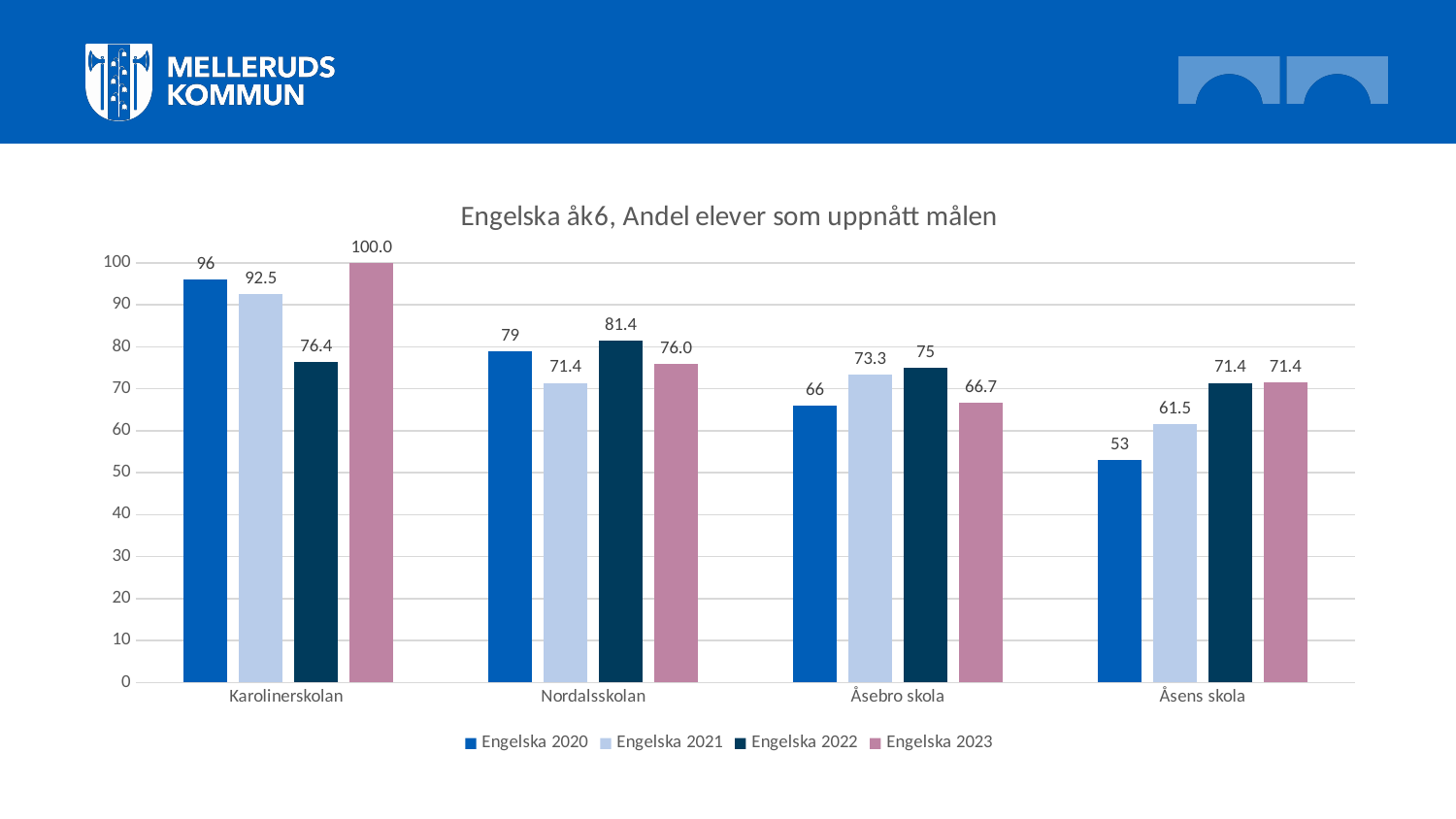
What kind of chart is shown on the slide? Bar chart What is the value for Engelska 2023 at Karolinerskolan? 100.0 Which school has the lowest value for Engelska 2021? Åsens skola Which is larger at Nordalsskolan: Engelska 2020 or Engelska 2021? Engelska 2020 What is the value for Engelska 2021 at Åsebro skola? 73.3 What is the title of the chart? Engelska åk6, Andel elever som uppnått målen What is the value for Engelska 2020 at Åsens skola? 53 What is the difference between Engelska 2020 and Engelska 2021 at Karolinerskolan? 3.5 What is the value for Engelska 2022 at Nordalsskolan? 81.4 Which school has the highest value for Engelska 2020? Karolinerskolan How many schools are shown on the x axis? 4 How many series does the legend list? 4